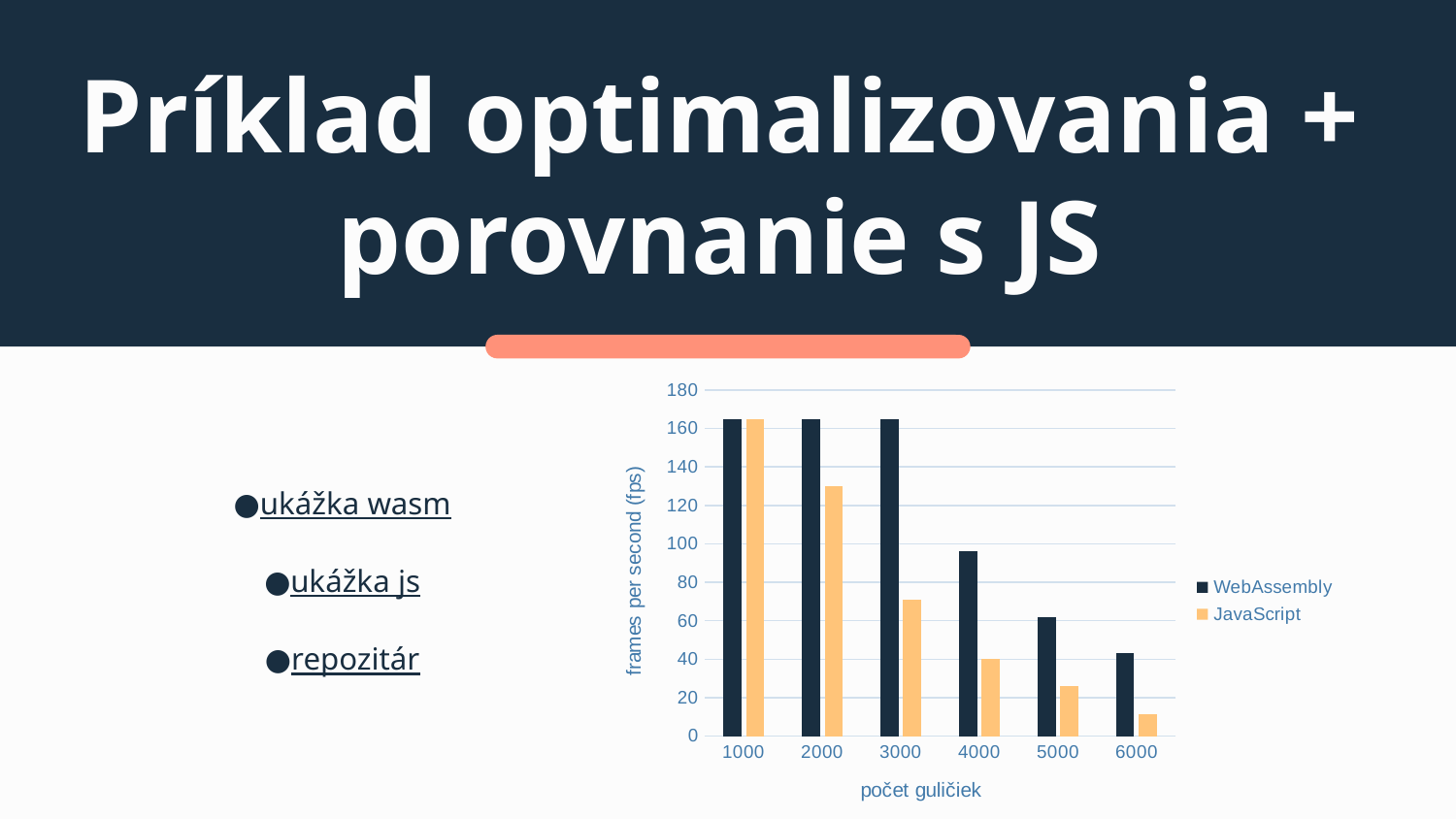
How many series does the chart's legend list? 2 Do the JavaScript values rise or fall as the number of balls increases along the x axis? fall Is the WebAssembly value for 4000 greater or less than 80? greater Is the JavaScript value for 3000 greater or less than 80? less At 4000, which series has the larger value, WebAssembly or JavaScript? WebAssembly What kind of chart is shown on the slide? bar chart Is the JavaScript value for 2000 greater or less than 120? greater How many categories are shown on the x axis of the chart? 6 What is the label of the chart's y axis? frames per second (fps) Which category has the lowest JavaScript value? 6000